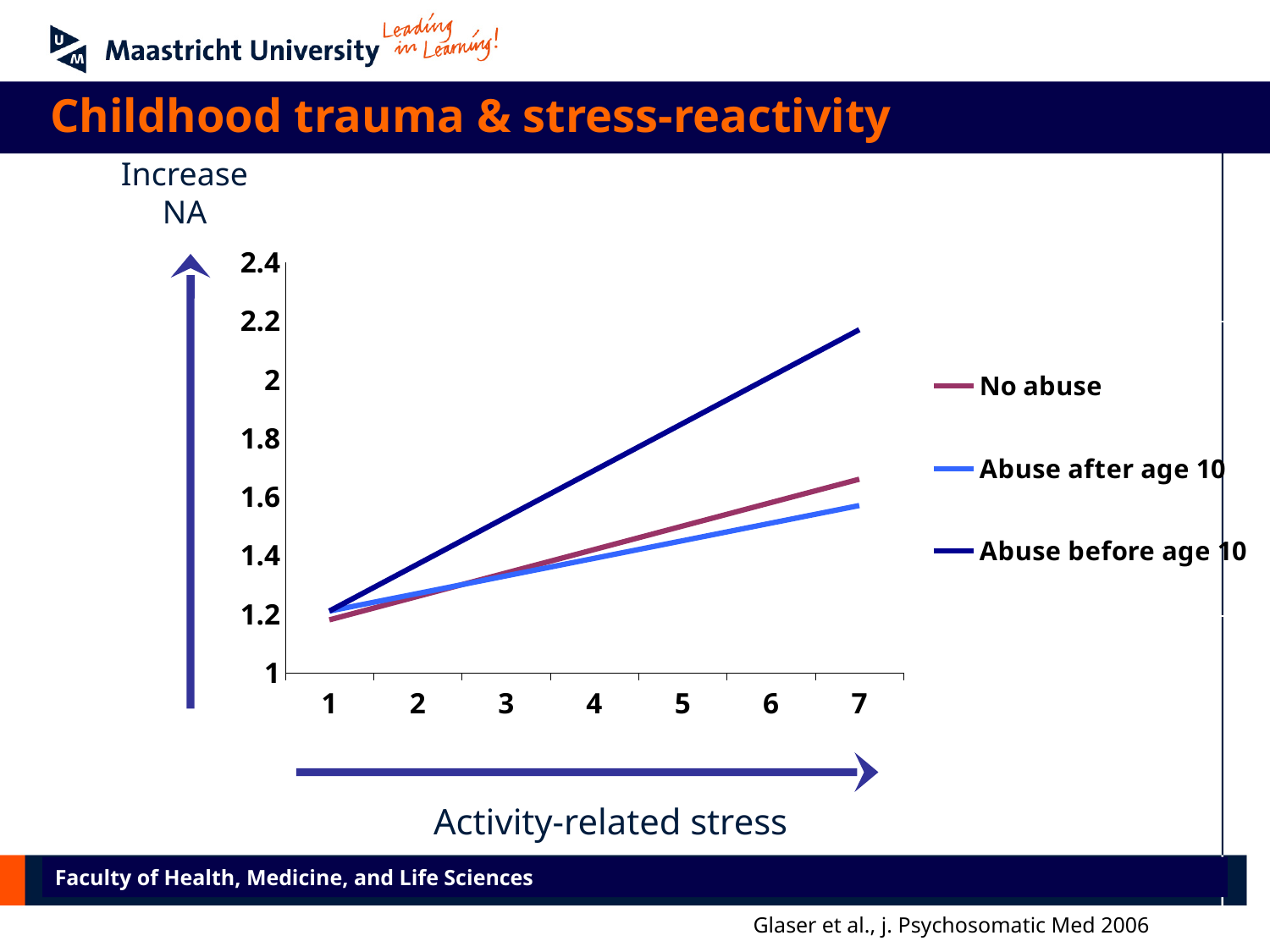
Is the value for Abuse after age 10 at x = 7 greater or less than 1.8? less Which series has the highest value at x = 7? Abuse before age 10 What is the title of the slide containing the chart? Childhood trauma & stress-reactivity At x = 7, which is larger: the value for Abuse before age 10 or the value for No abuse? Abuse before age 10 Do the values for Abuse before age 10 rise or fall as x increases from 1 to 7? rise Is the value for No abuse at x = 7 greater or less than 1.8? less How many series does the legend list? 3 How many points are marked along the x axis? 7 Is the value for Abuse before age 10 at x = 1 greater or less than 1.4? less What label is shown along the x axis of the chart? Activity-related stress What kind of chart is shown on the slide? line chart